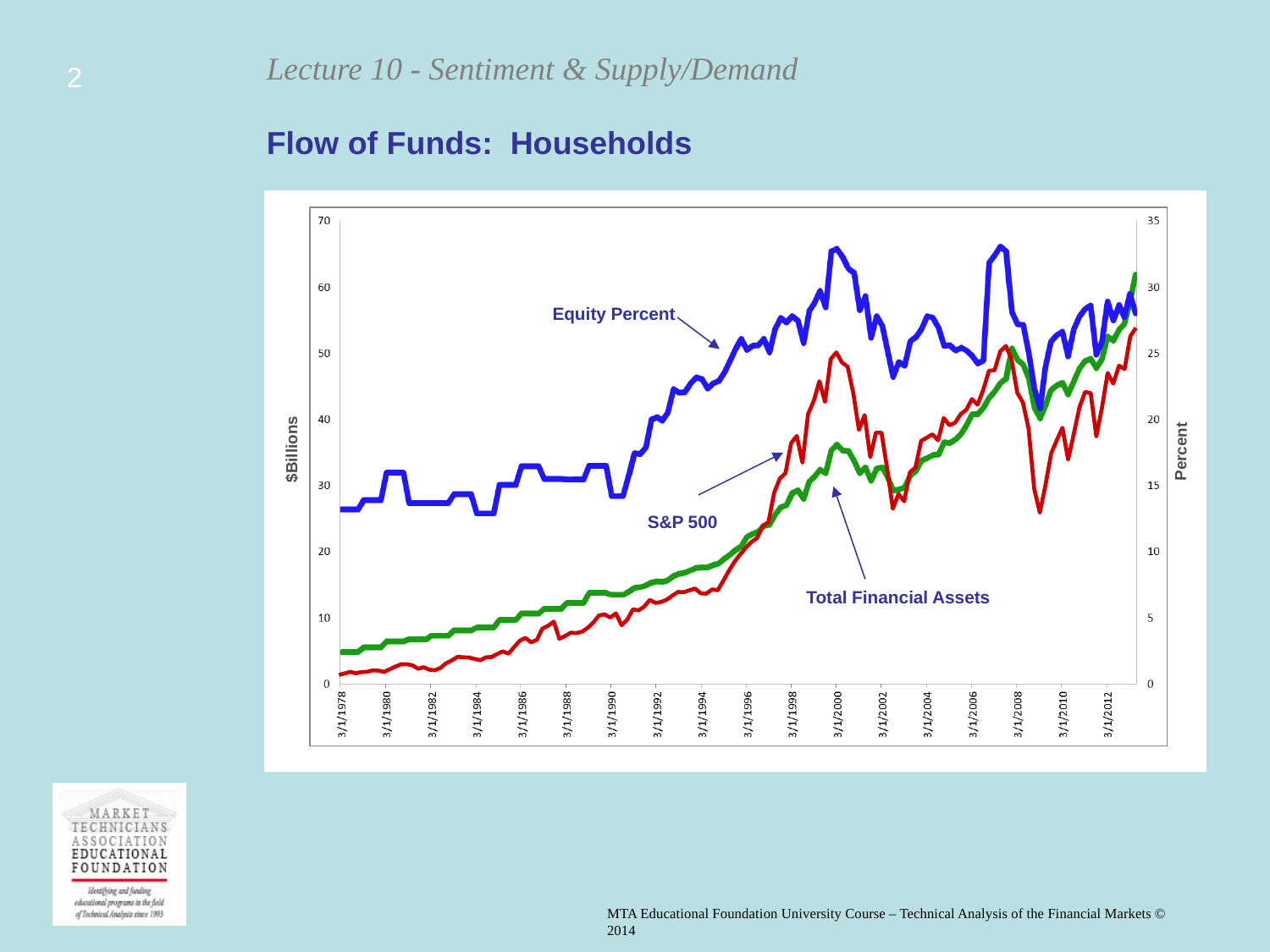
At 3/1/2000, which is higher on the $Billions axis: the S&P 500 or Total Financial Assets? S&P 500 At 3/1/1990, which is higher on the $Billions axis: the S&P 500 or Total Financial Assets? Total Financial Assets What kind of chart is shown on the slide? line chart What is the label of the left vertical axis? $Billions What is the title of the chart on the slide? Flow of Funds: Households Does the Equity Percent series rise or fall overall between 3/1/1978 and 3/1/2000? rise Is the peak of the Equity Percent series around 3/1/2000 greater or less than 30 on the Percent axis? greater Is the Total Financial Assets value at 3/1/2000 greater or less than 30 on the $Billions axis? greater How many data series are plotted on the chart? 3 Is the S&P 500 value at 3/1/1978 greater or less than 5 on the $Billions axis? less Does the Total Financial Assets series generally rise or fall from 3/1/1978 to 3/1/2012? rise